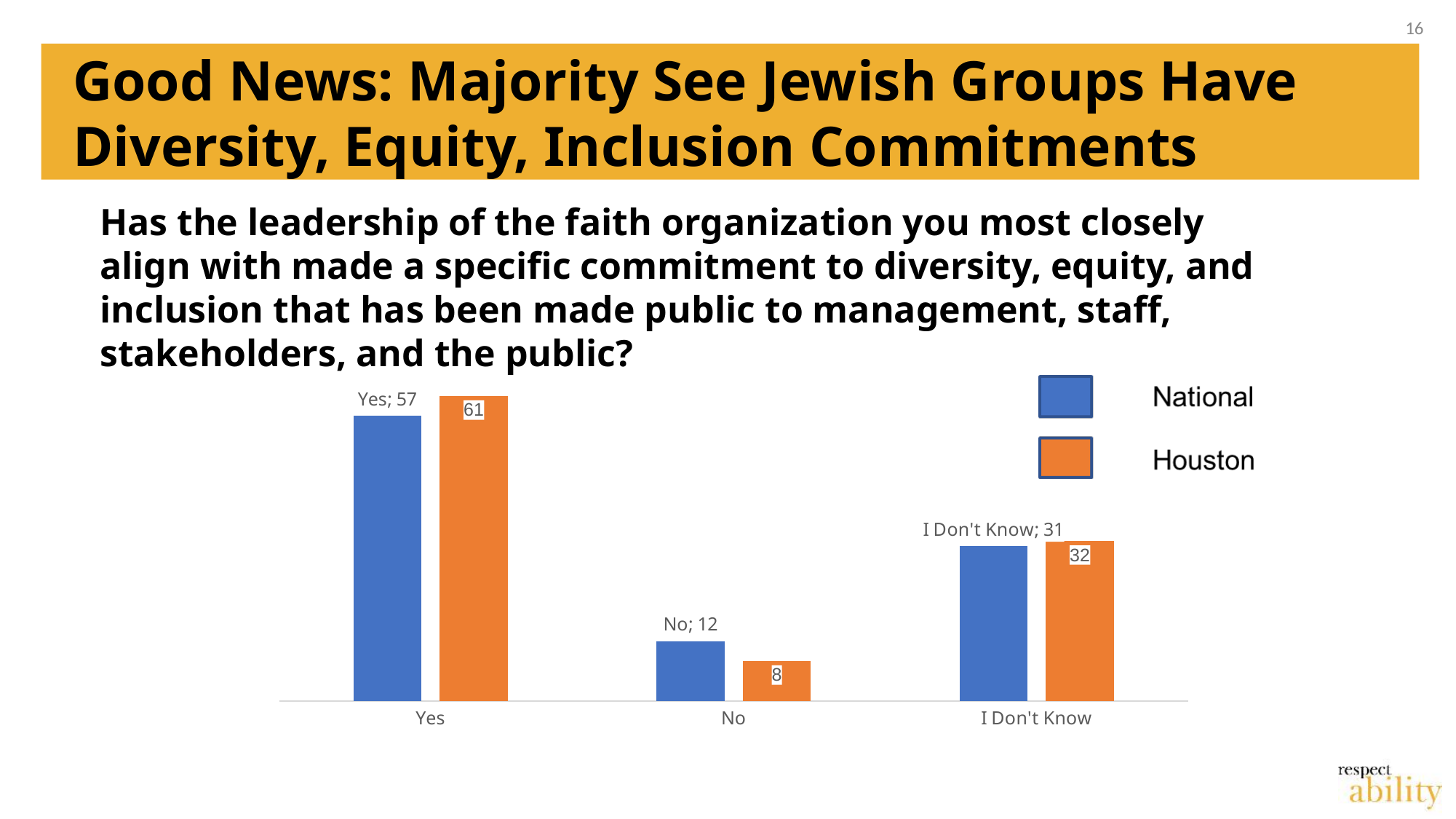
What is the Houston value for Yes? 61 Which category has the lowest National value? No What is the Houston value for I Don't Know? 32 What is the National value for No? 12 How many series does the legend list? 2 What is the National value for Yes? 57 What kind of chart is shown on the slide? Bar chart Which is larger for No: the National value or the Houston value? National Which category has the highest Houston value? Yes What is the difference between the Houston and National values for Yes? 4 How many categories are shown on the x axis? 3 What is the difference between the National and Houston values for No? 4